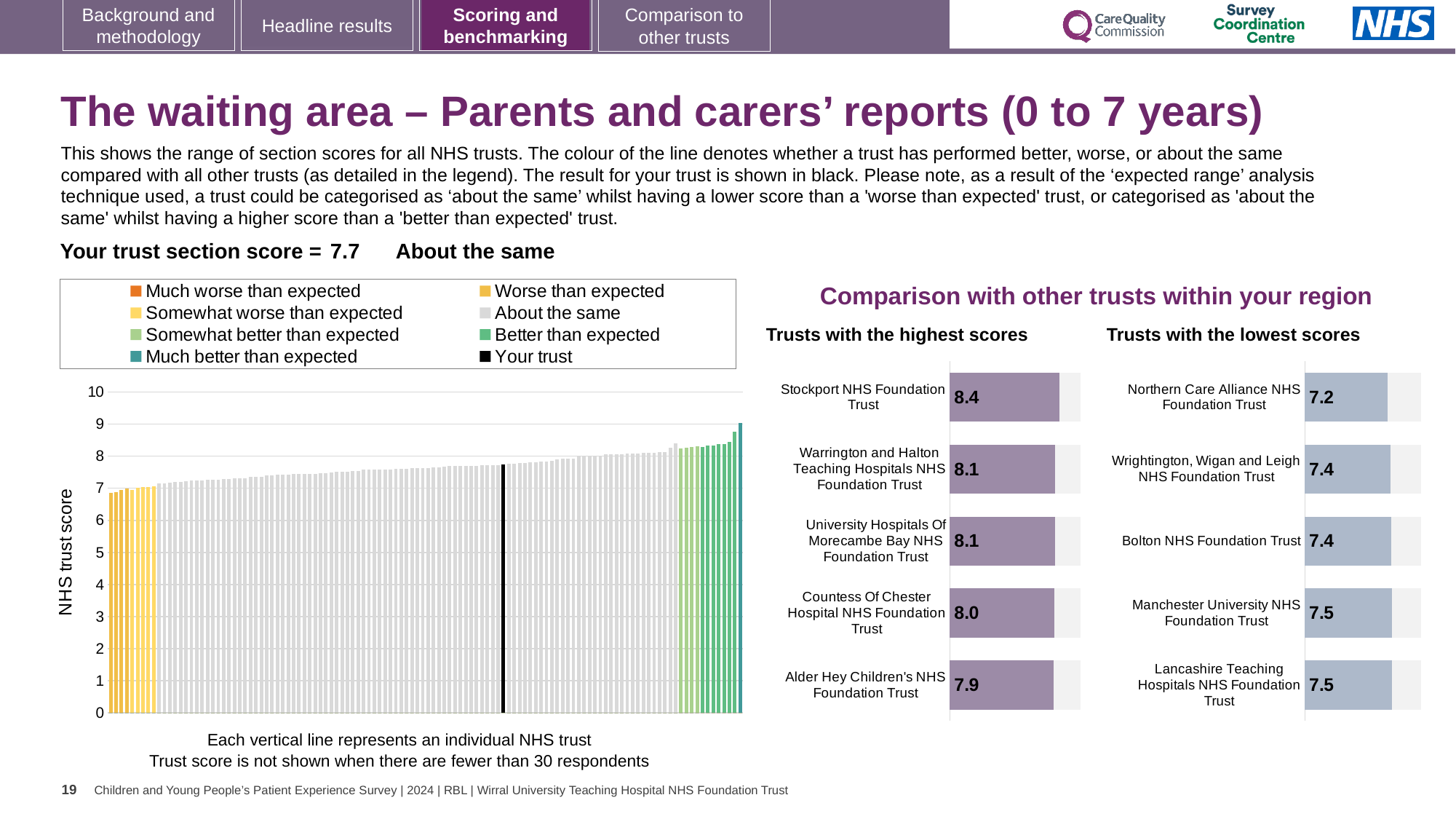
In the 'Trusts with the highest scores' chart, what is the difference between the scores of Stockport NHS Foundation Trust and Countess Of Chester Hospital NHS Foundation Trust? 0.4 In the 'NHS trust score' chart on the left, is the value for the black bar (your trust) greater or less than 7? greater In the 'Trusts with the highest scores' chart, what is the score for Alder Hey Children's NHS Foundation Trust? 7.9 In the 'Trusts with the lowest scores' chart, which has the higher score: Northern Care Alliance NHS Foundation Trust or Manchester University NHS Foundation Trust? Manchester University NHS Foundation Trust In the 'Trusts with the lowest scores' chart, what is the score for Bolton NHS Foundation Trust? 7.4 How many trusts are shown in the 'Trusts with the highest scores' chart? 5 What kind of chart is the 'NHS trust score' chart on the left of the slide? Bar chart In the 'Trusts with the highest scores' chart, which trust has the highest score? Stockport NHS Foundation Trust In the 'Trusts with the lowest scores' chart, which trust has the lowest score? Northern Care Alliance NHS Foundation Trust How many entries does the legend of the 'NHS trust score' chart on the left list? 8 In the 'Trusts with the highest scores' chart, what is the score for Stockport NHS Foundation Trust? 8.4 In the 'Trusts with the lowest scores' chart, what is the score for Northern Care Alliance NHS Foundation Trust? 7.2